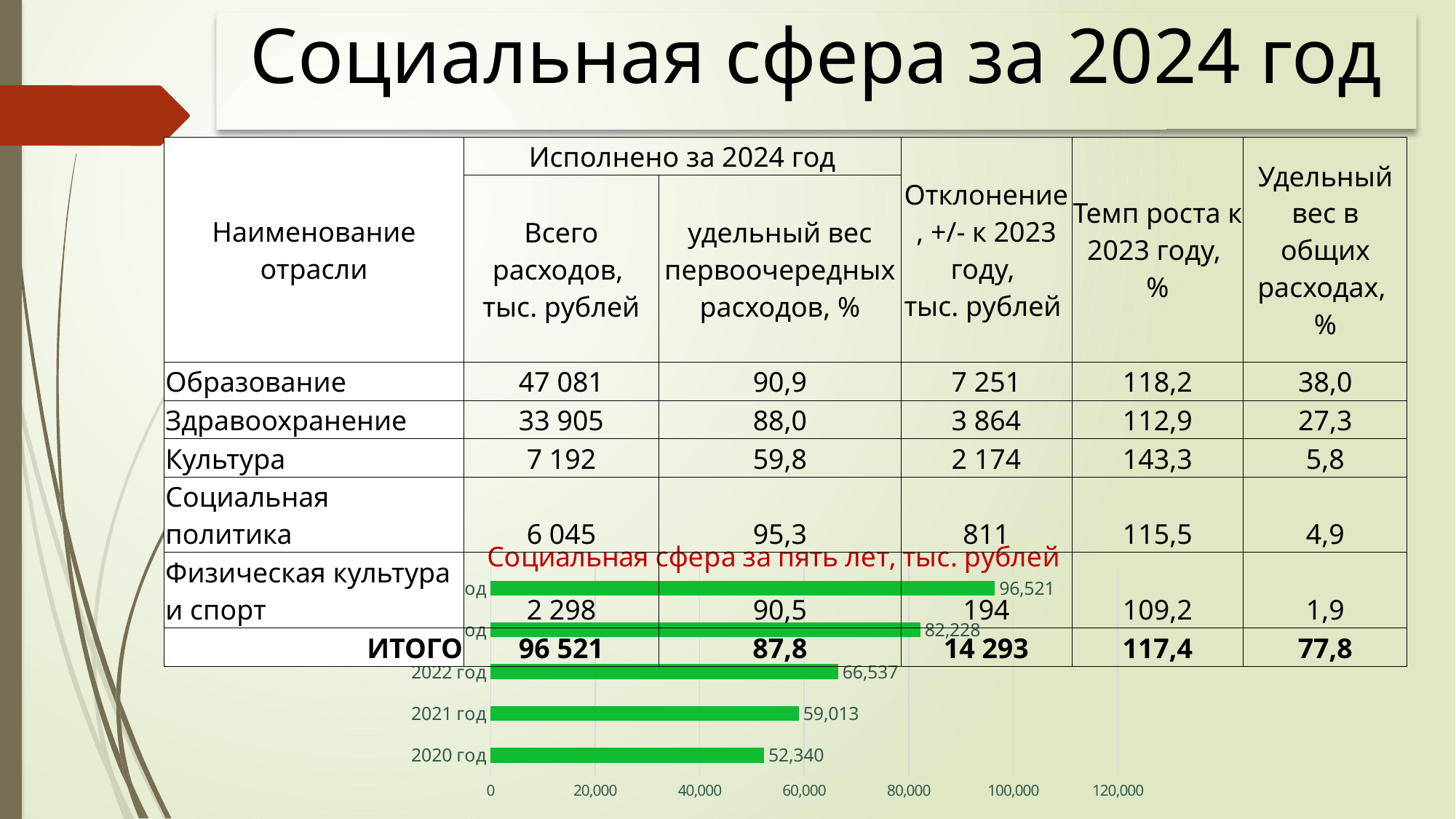
Is the value for 2022 год greater or less than 60,000? greater What is the value for 2020 год in the chart? 52,340 What is the value for 2021 год in the chart? 59,013 How many bars does the chart have? 5 What is the value for 2022 год in the chart? 66,537 What is the difference between the values for 2022 год and 2021 год? 7,524 What is the largest value shown in the chart? 96,521 What kind of chart is shown on the slide? bar chart Which is larger, the value for 2021 год or the value for 2020 год? 2021 год Do the values in the chart rise or fall from 2020 год to the most recent year? rise What is the smallest value shown in the chart? 52,340 What is the title of the chart on the slide? Социальная сфера за пять лет, тыс. рублей